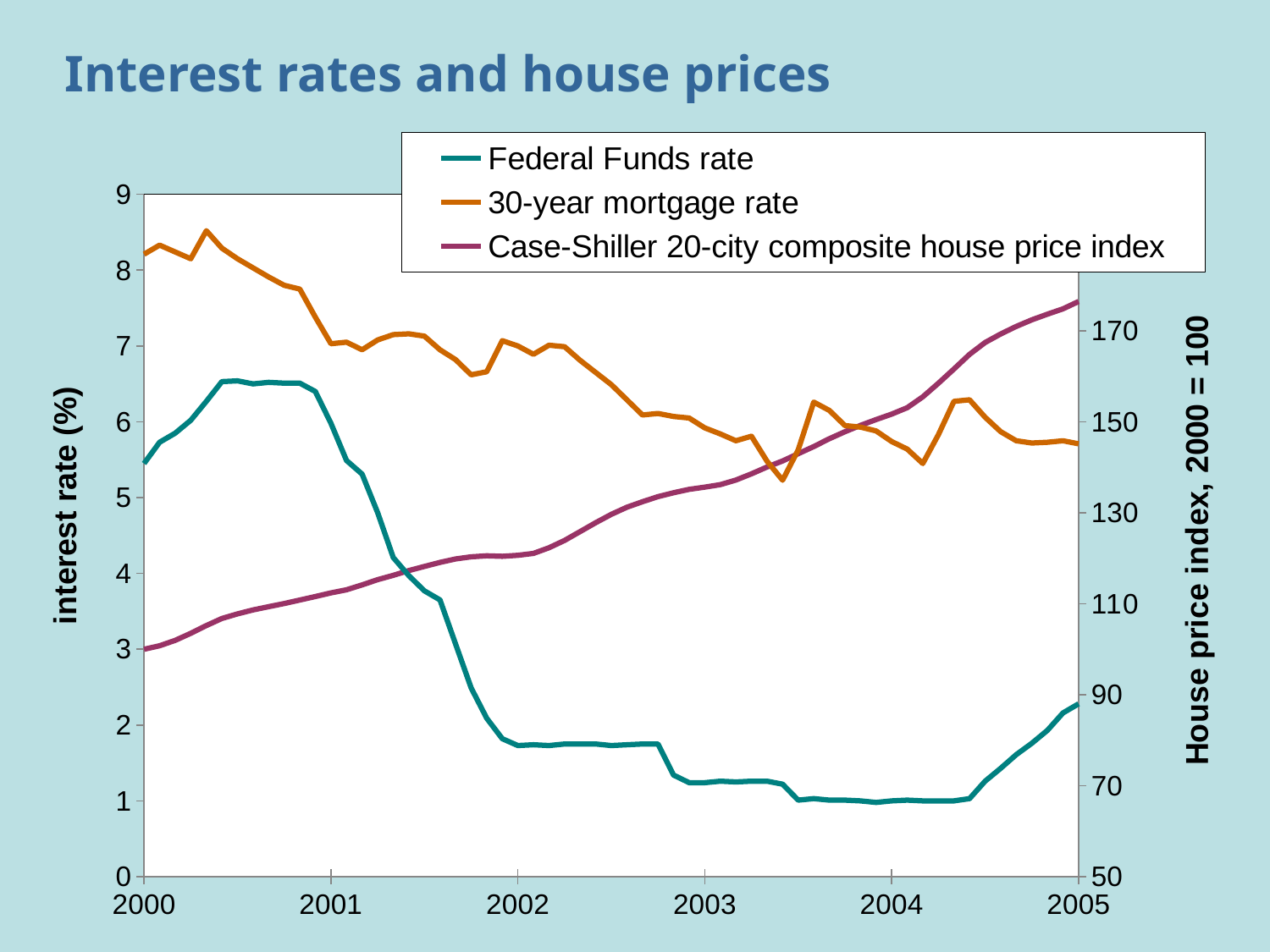
At the start of 2000, which is higher: the Federal Funds rate or the 30-year mortgage rate? 30-year mortgage rate Does the Case-Shiller 20-city composite house price index rise or fall from 2000 to 2005? rise How many series does the legend list? 3 What kind of chart is shown on the slide? line chart Is the Federal Funds rate at the start of 2000 greater or less than 5? greater Is the Federal Funds rate at the start of 2004 greater or less than 2? less What is the title of the chart? Interest rates and house prices Is the Case-Shiller house price index at 2005 greater or less than 170? greater What is the label of the right-hand vertical axis? House price index, 2000 = 100 What is the value of the Case-Shiller 20-city composite house price index at the start of 2000? 100 Does the Federal Funds rate rise or fall between 2000 and 2004? fall